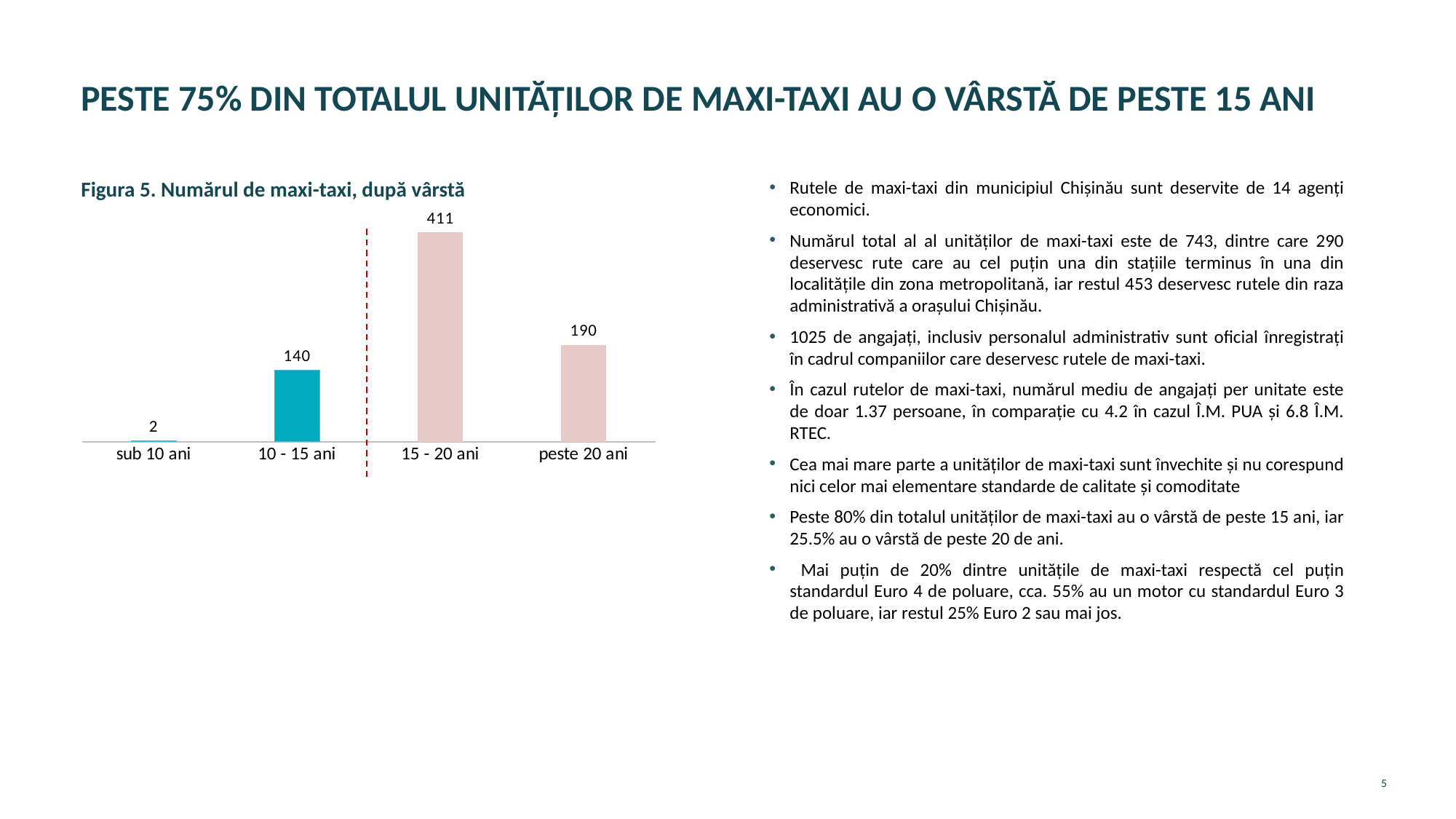
What is the difference between the values for 'peste 20 ani' and '10 - 15 ani'? 50 What is the difference between the values for '15 - 20 ani' and 'peste 20 ani'? 221 What is the value for the '15 - 20 ani' category? 411 Which category has the highest value? 15 - 20 ani How many categories are shown on the x axis of the chart? 4 What kind of chart is shown on the slide? bar chart Which is larger, the value for '10 - 15 ani' or the value for 'peste 20 ani'? peste 20 ani What is the value for the 'sub 10 ani' category? 2 What is the value for the 'peste 20 ani' category? 190 Which category has the lowest value? sub 10 ani What is the title of the chart? Figura 5. Numărul de maxi-taxi, după vârstă What is the value for the '10 - 15 ani' category? 140